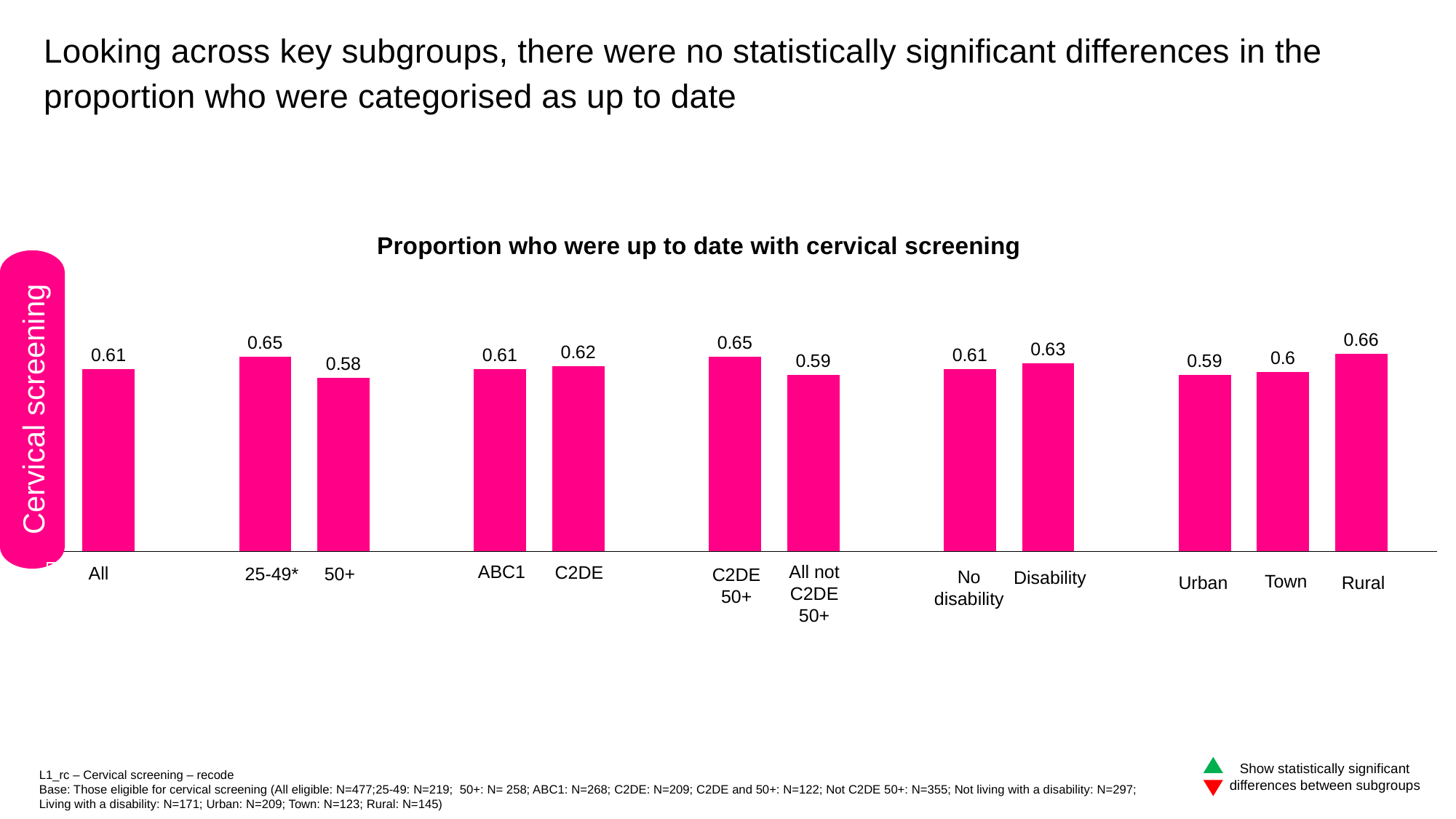
What is the value for the 'All' bar in the chart 'Proportion who were up to date with cervical screening'? 0.61 Which has a higher value, C2DE 50+ or All not C2DE 50+? C2DE 50+ What is the value shown for the 50+ subgroup? 0.58 What type of chart is shown on the slide? Bar chart What is the difference between the values for Rural and Urban? 0.07 Which subgroup has the lowest proportion up to date with cervical screening? 50+ What is the title of the chart? Proportion who were up to date with cervical screening What is the value shown for the Disability subgroup? 0.63 What is the difference between the values for 25-49* and 50+? 0.07 Which subgroup has the highest proportion up to date with cervical screening? Rural What proportion of the Rural subgroup were up to date with cervical screening? 0.66 How many bars are plotted in the chart? 12